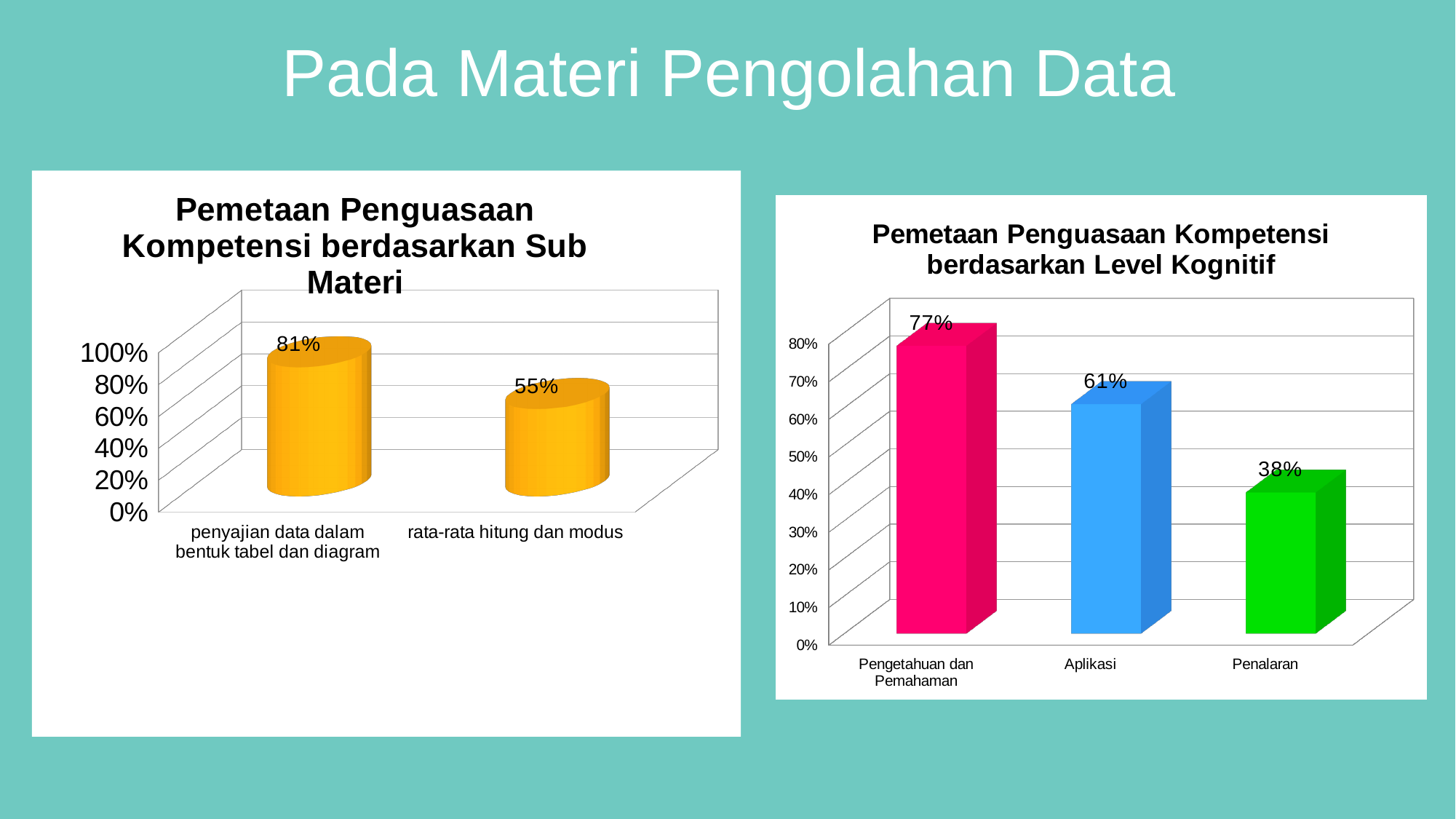
In the chart 'Pemetaan Penguasaan Kompetensi berdasarkan Sub Materi', what is the value for 'penyajian data dalam bentuk tabel dan diagram'? 81% What kind of chart is the chart on the right of the slide? bar chart In the chart 'Pemetaan Penguasaan Kompetensi berdasarkan Level Kognitif', what is the difference between 'Pengetahuan dan Pemahaman' and 'Penalaran'? 39% In the chart 'Pemetaan Penguasaan Kompetensi berdasarkan Level Kognitif', which category has the highest value? Pengetahuan dan Pemahaman In the chart 'Pemetaan Penguasaan Kompetensi berdasarkan Level Kognitif', which category has the lowest value? Penalaran In the chart 'Pemetaan Penguasaan Kompetensi berdasarkan Sub Materi', what is the difference between the two values? 26% In the chart 'Pemetaan Penguasaan Kompetensi berdasarkan Level Kognitif', what is the value for 'Aplikasi'? 61% In the chart 'Pemetaan Penguasaan Kompetensi berdasarkan Sub Materi', how many categories are shown? 2 In the chart 'Pemetaan Penguasaan Kompetensi berdasarkan Level Kognitif', do the values rise or fall from left to right? fall In the chart 'Pemetaan Penguasaan Kompetensi berdasarkan Sub Materi', what is the value for 'rata-rata hitung dan modus'? 55% In the chart 'Pemetaan Penguasaan Kompetensi berdasarkan Level Kognitif', what is the value for 'Penalaran'? 38% In the chart 'Pemetaan Penguasaan Kompetensi berdasarkan Sub Materi', which category has the highest value? penyajian data dalam bentuk tabel dan diagram